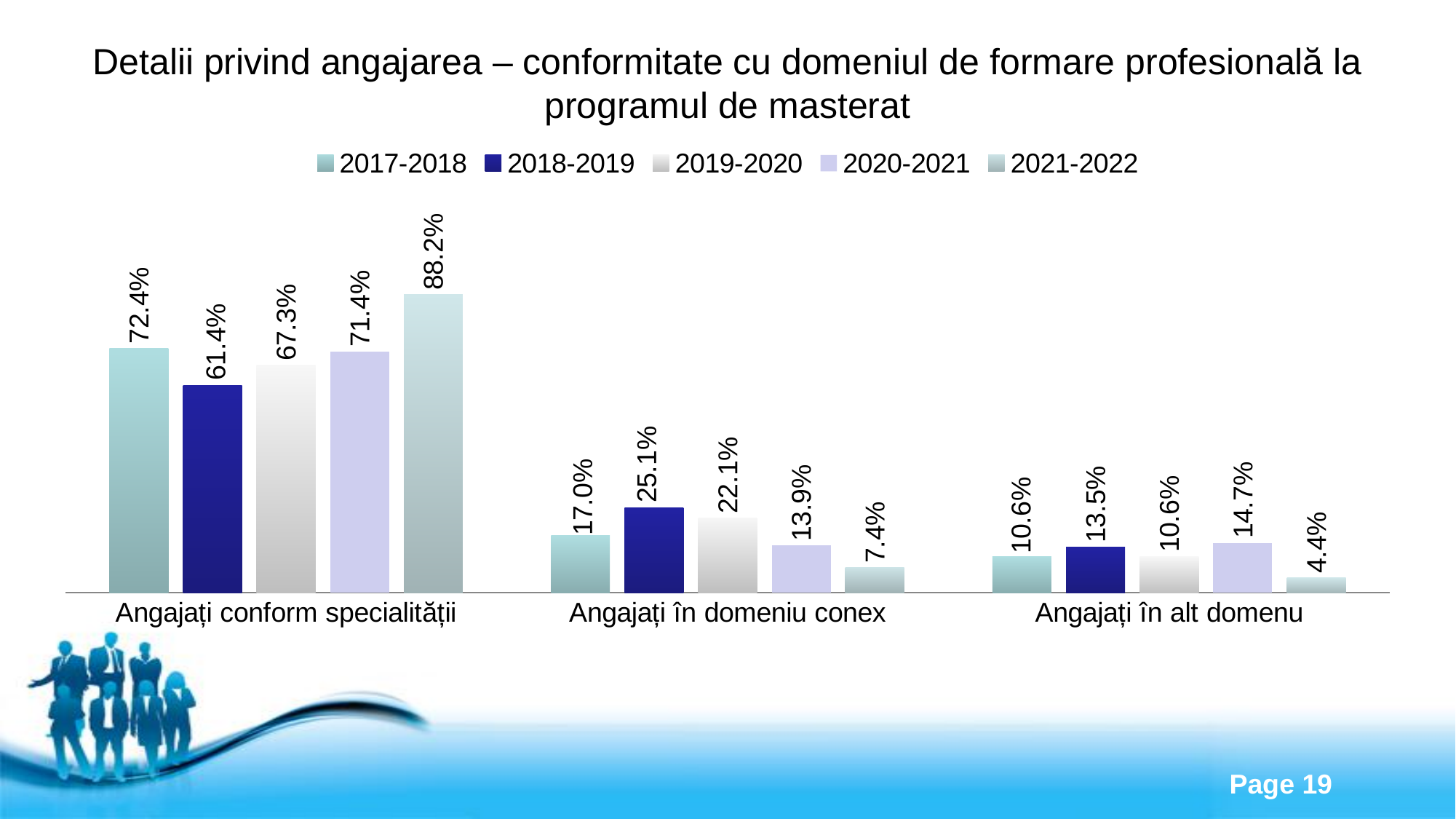
What is the value for 2021-2022 in the 'Angajați conform specialității' category? 88.2% What is the value for 2020-2021 in the 'Angajați în alt domenu' category? 14.7% What is the difference between the 2018-2019 and 2021-2022 values in the 'Angajați în domeniu conex' category? 17.7% Which series has the highest value in the 'Angajați conform specialității' category? 2021-2022 What is the value for 2018-2019 in the 'Angajați în domeniu conex' category? 25.1% How many series does the legend list? 5 What kind of chart is shown on the slide? Bar chart Which series is shown in dark blue in the legend? 2018-2019 How many categories are shown on the x axis? 3 Which is larger in the 'Angajați în domeniu conex' category: the 2017-2018 value or the 2019-2020 value? 2019-2020 What is the difference between the 2021-2022 and 2018-2019 values in the 'Angajați conform specialității' category? 26.8% Which series has the lowest value in the 'Angajați în alt domenu' category? 2021-2022